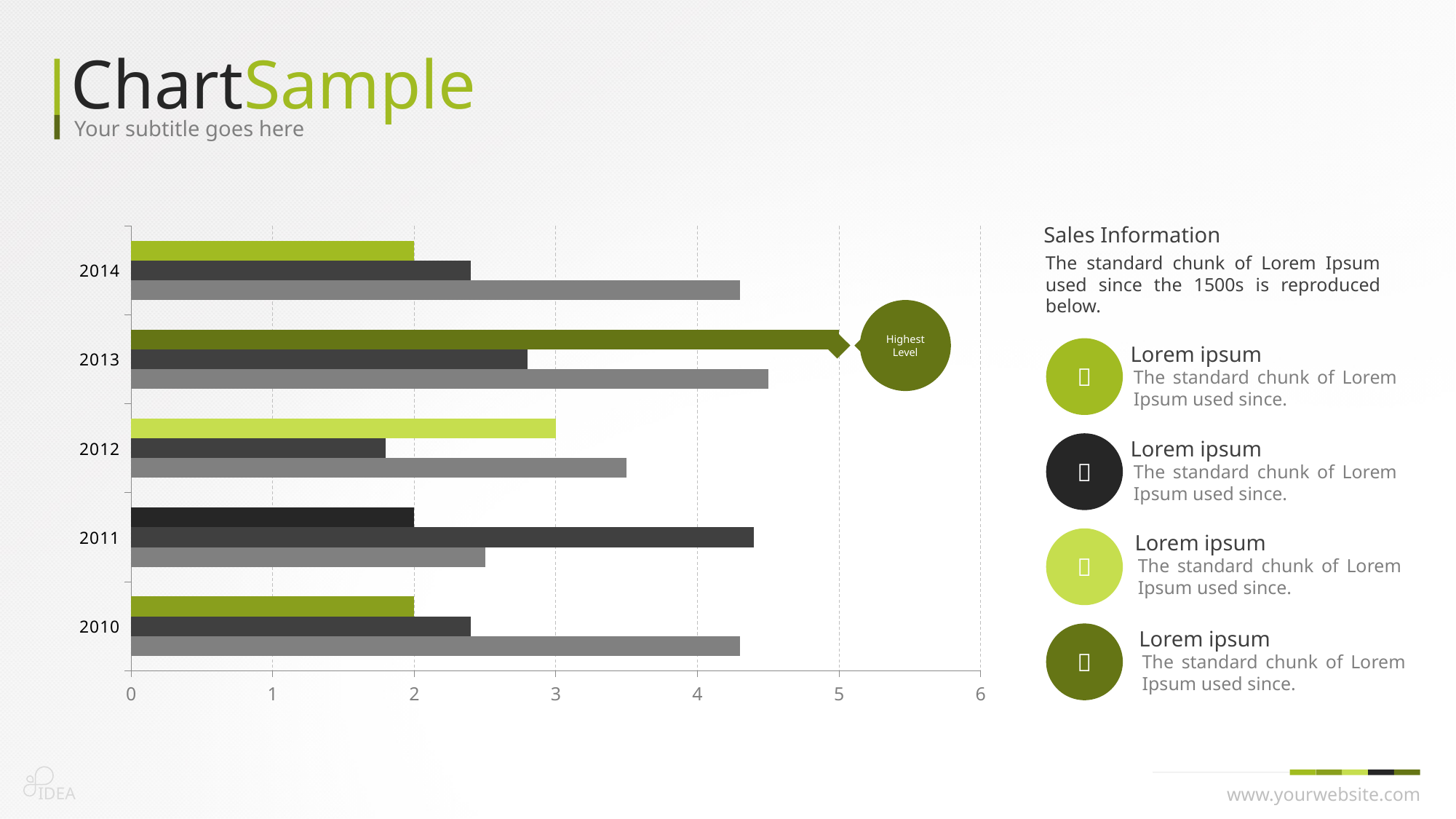
Is the value of the bottom (grey) bar for 2013 greater or less than 4? greater Is the value of the top (dark green) bar for 2013 greater or less than 4? greater What text appears in the circular callout attached to the 2013 bar? Highest Level What is the value of the top (light green) bar for 2012? 3 Which is larger: the bottom (grey) bar for 2011 or the bottom (grey) bar for 2010? 2010 Which year has the longest bar on the chart? 2013 What is the value of the top (green) bar for 2014? 2 What is the value of the top (black) bar for 2011? 2 How many year categories are shown on the chart's vertical axis? 5 Is the value of the middle (dark grey) bar for 2012 greater or less than 2? less What is the value of the top (green) bar for 2010? 2 What kind of chart is shown on the slide? bar chart